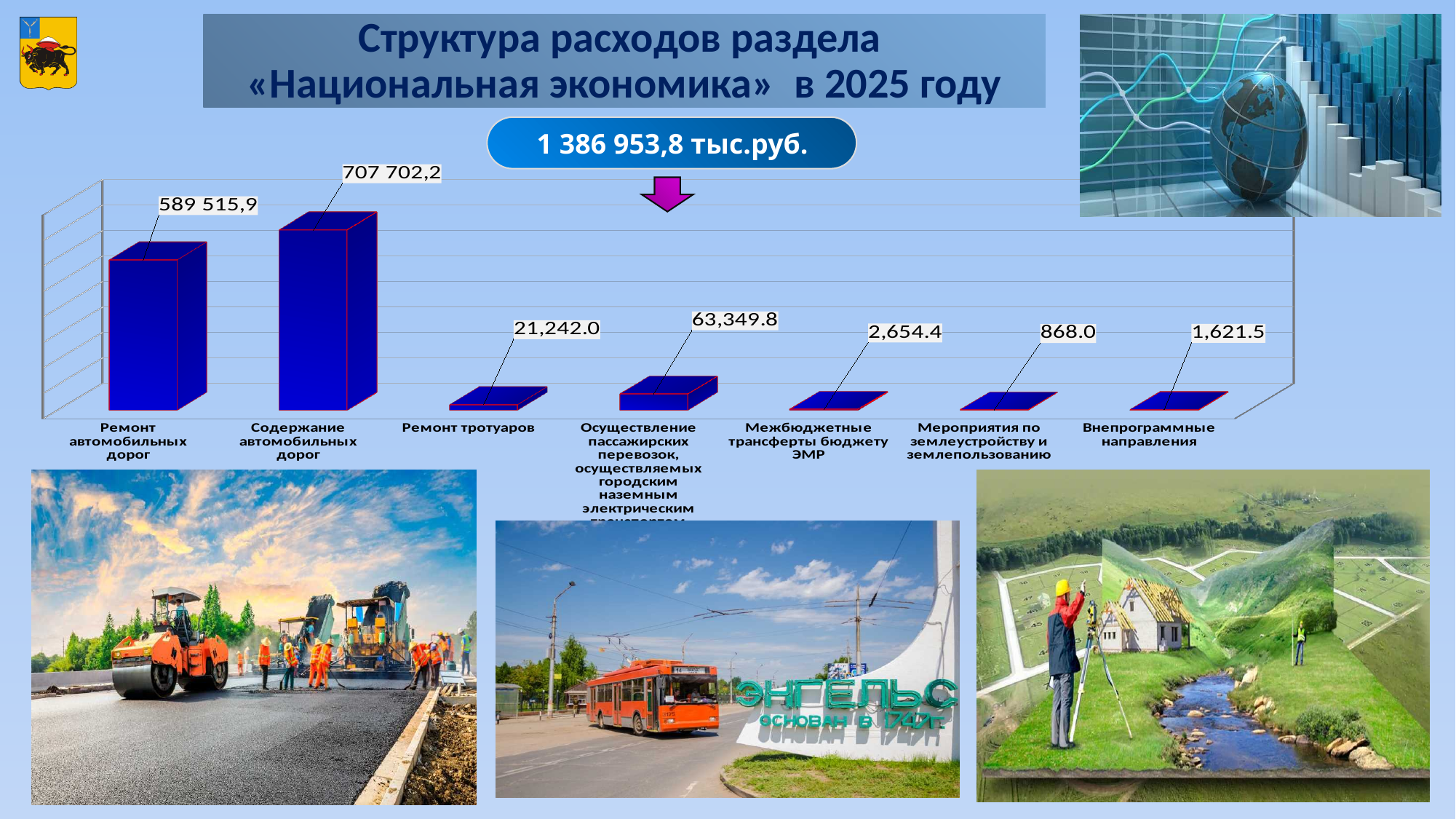
What is the value for «Межбюджетные трансферты бюджету ЭМР»? 2,654.4 What is the value for «Ремонт тротуаров»? 21,242.0 What total amount in тыс.руб. is shown above the chart? 1 386 953,8 тыс.руб. What is the value for «Внепрограммные направления»? 1,621.5 What is the value for «Ремонт автомобильных дорог»? 589 515,9 What is the difference between the values for «Содержание автомобильных дорог» and «Ремонт автомобильных дорог»? 118 186,3 How many categories are shown in the chart? 7 What kind of chart is shown on the slide? Bar chart Which is larger: the value for «Ремонт тротуаров» or the value for «Осуществление пассажирских перевозок»? Осуществление пассажирских перевозок Which category has the highest value? Содержание автомобильных дорог What is the value for «Содержание автомобильных дорог»? 707 702,2 Which category has the lowest value? Мероприятия по землеустройству и землепользованию